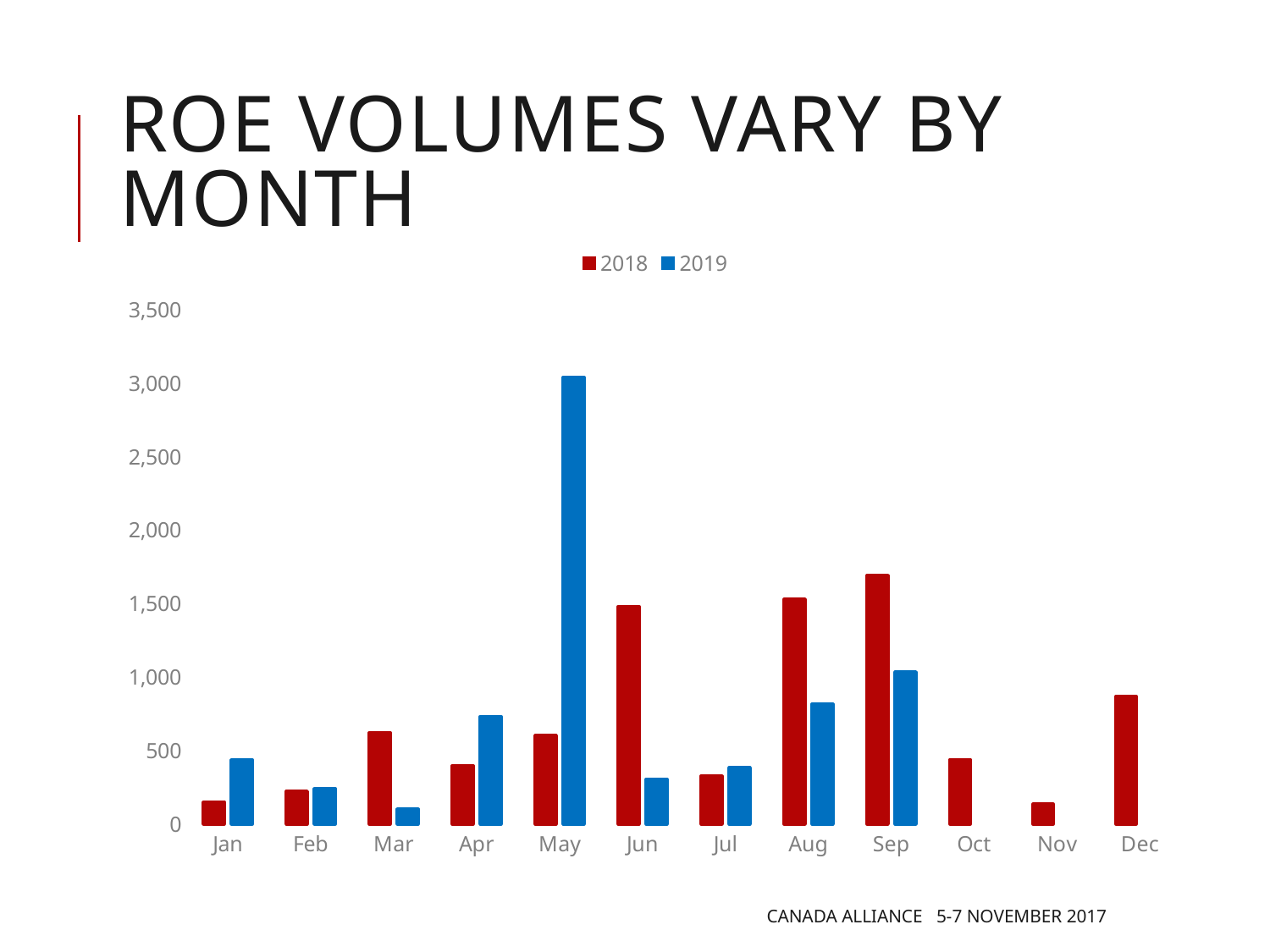
Which month has the highest value for the 2018 series? Sep What kind of chart is shown on the slide? bar chart In Apr, which series has the larger value, 2018 or 2019? 2019 Is the 2018 value for Dec greater or less than 1,000? less Which month has the lowest value for the 2019 series among the months where a 2019 bar is shown? Mar Is the 2019 value for May greater or less than 2,500? greater Which colour represents the 2019 series in the legend? blue Which month has the highest value for the 2019 series? May How many series does the legend list? 2 In Mar, which series has the larger value, 2018 or 2019? 2018 How many months are shown on the x axis? 12 Is the 2018 value for Sep greater or less than 1,500? greater